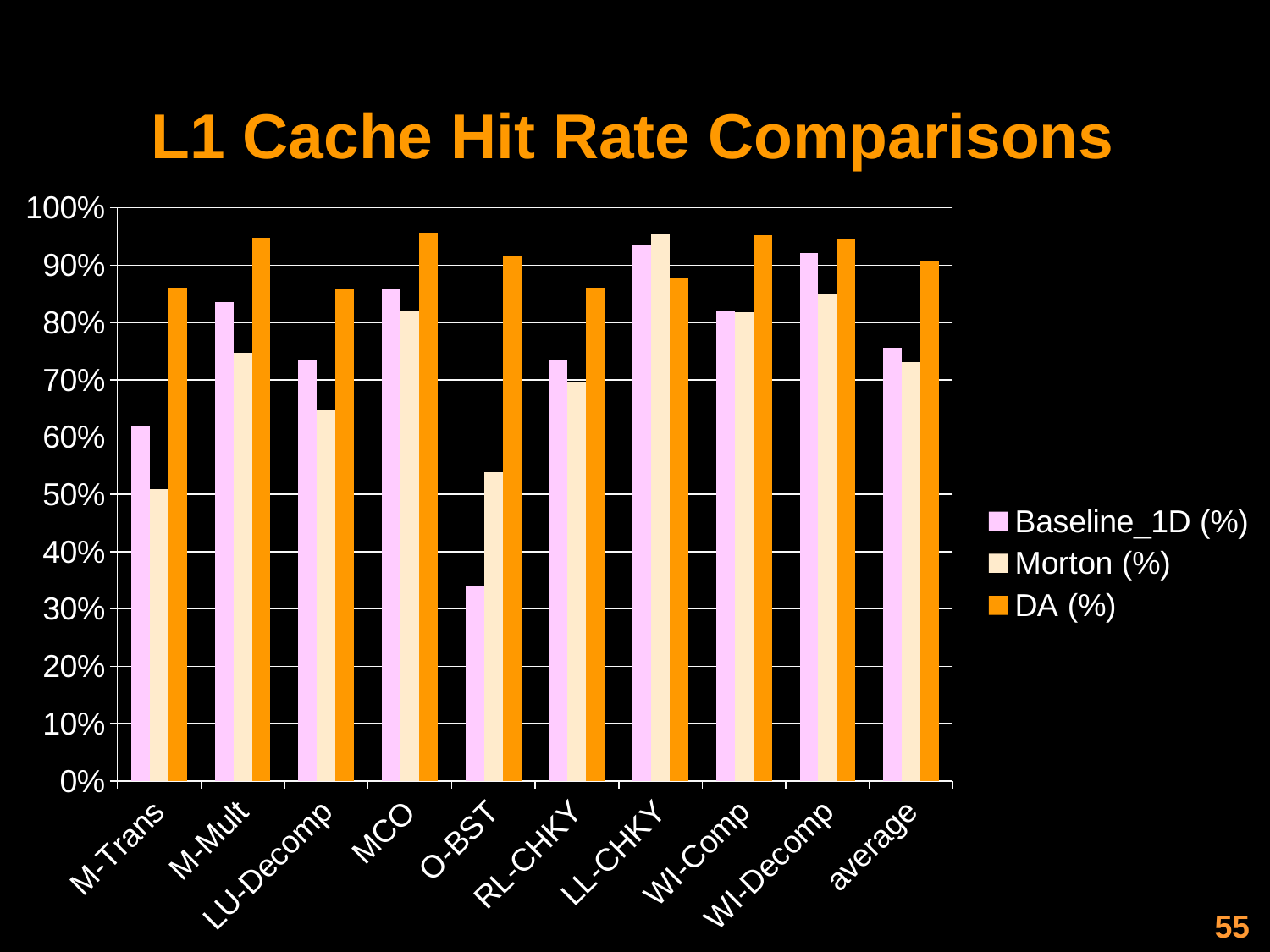
Which category has the lowest Baseline_1D (%) value? O-BST What is the title of the chart? L1 Cache Hit Rate Comparisons How many categories are shown on the x axis? 10 How many series does the legend list? 3 For O-BST, which is larger: the Baseline_1D (%) value or the Morton (%) value? Morton (%) What kind of chart is shown on the slide? bar chart Is the DA (%) value for LL-CHKY greater or less than 90%? less Is the Baseline_1D (%) value for O-BST greater or less than 40%? less For LL-CHKY, which is larger: the Morton (%) value or the DA (%) value? Morton (%) Is the DA (%) value for M-Mult greater or less than 90%? greater Which series is drawn in dark orange? DA (%)